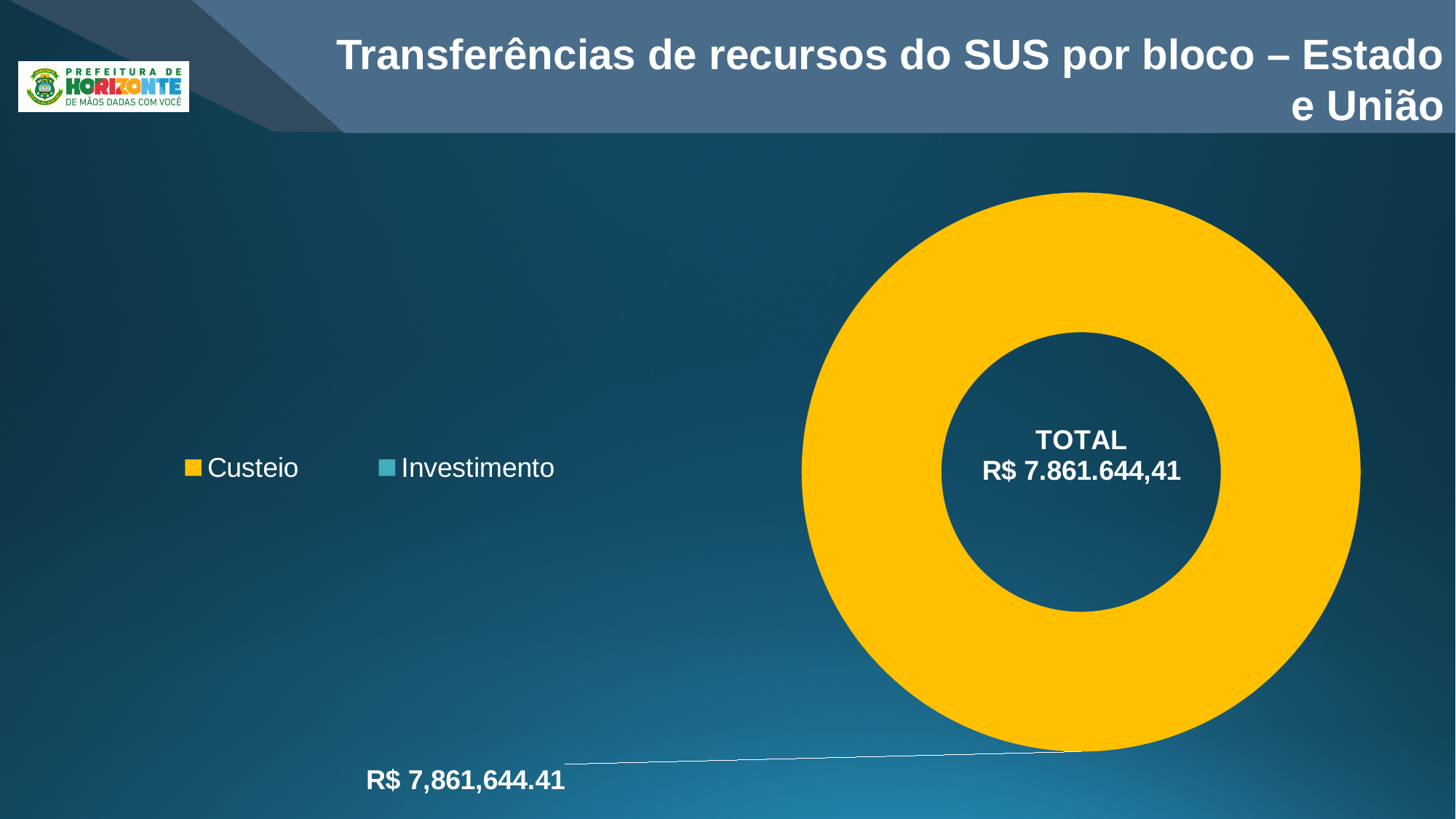
Which is larger, Custeio or Investimento? Custeio What kind of chart is shown on the slide? doughnut chart How many entries does the chart legend list? 2 Which category accounts for the largest share of the doughnut chart? Custeio What colour represents Custeio in the chart? yellow What value is shown by the data label for Custeio? R$ 7,861,644.41 Which category accounts for the smallest share of the doughnut chart? Investimento What total is printed in the centre of the doughnut chart? R$ 7.861.644,41 What is the title of the slide containing the chart? Transferências de recursos do SUS por bloco – Estado e União